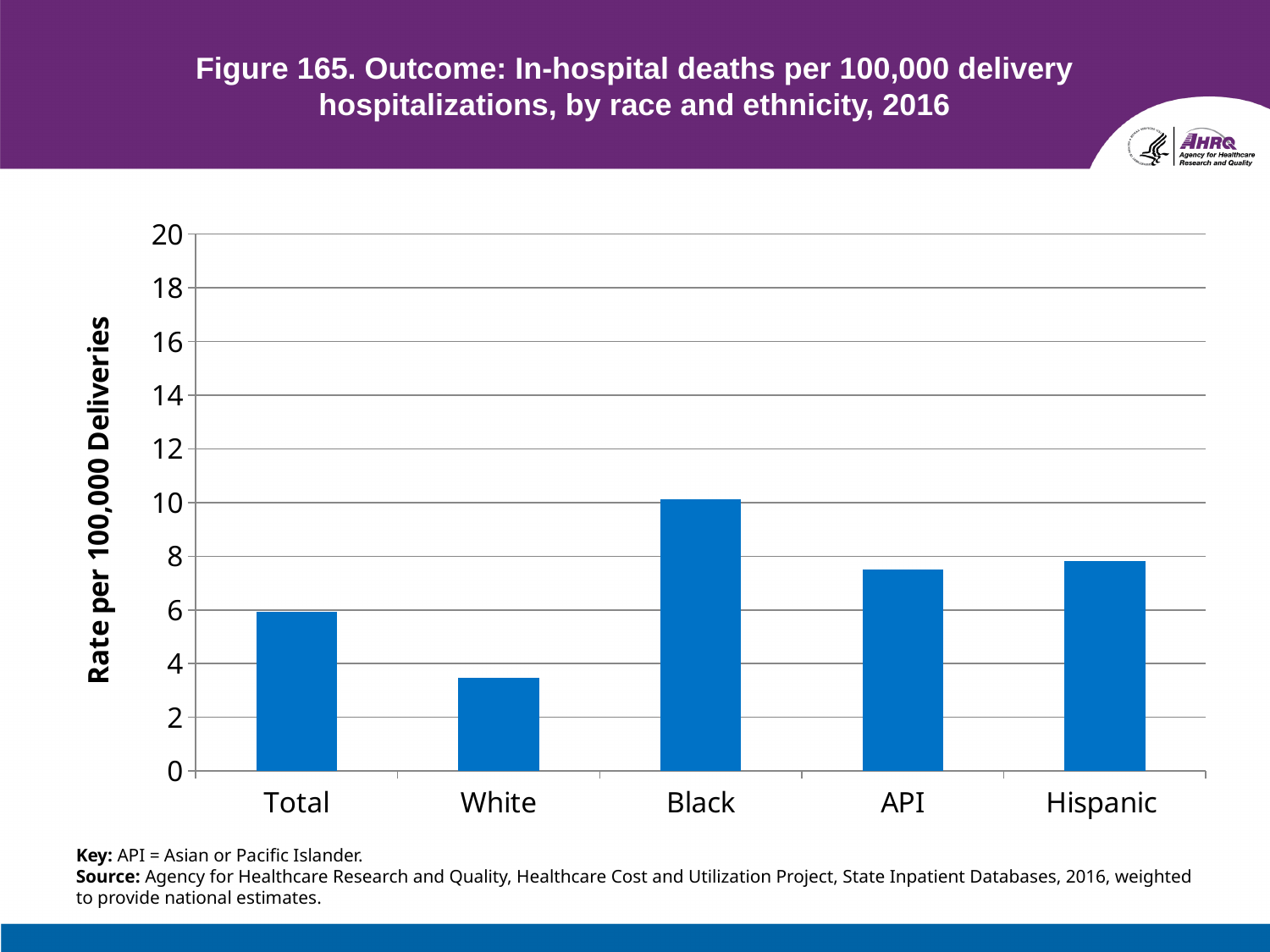
Which is larger, the value for Black or the value for White? Black Is the value for Hispanic greater or less than 6? greater Which category has the lowest rate of in-hospital deaths per 100,000 deliveries? White Which is larger, the value for Total or the value for API? API How many categories are shown on the x axis of the chart? 5 Is the value for API greater or less than 8? less What is the label on the vertical axis of the chart? Rate per 100,000 Deliveries Is the value for Total greater or less than 4? greater What kind of chart is shown on the slide? bar chart Which category has the highest rate of in-hospital deaths per 100,000 deliveries? Black